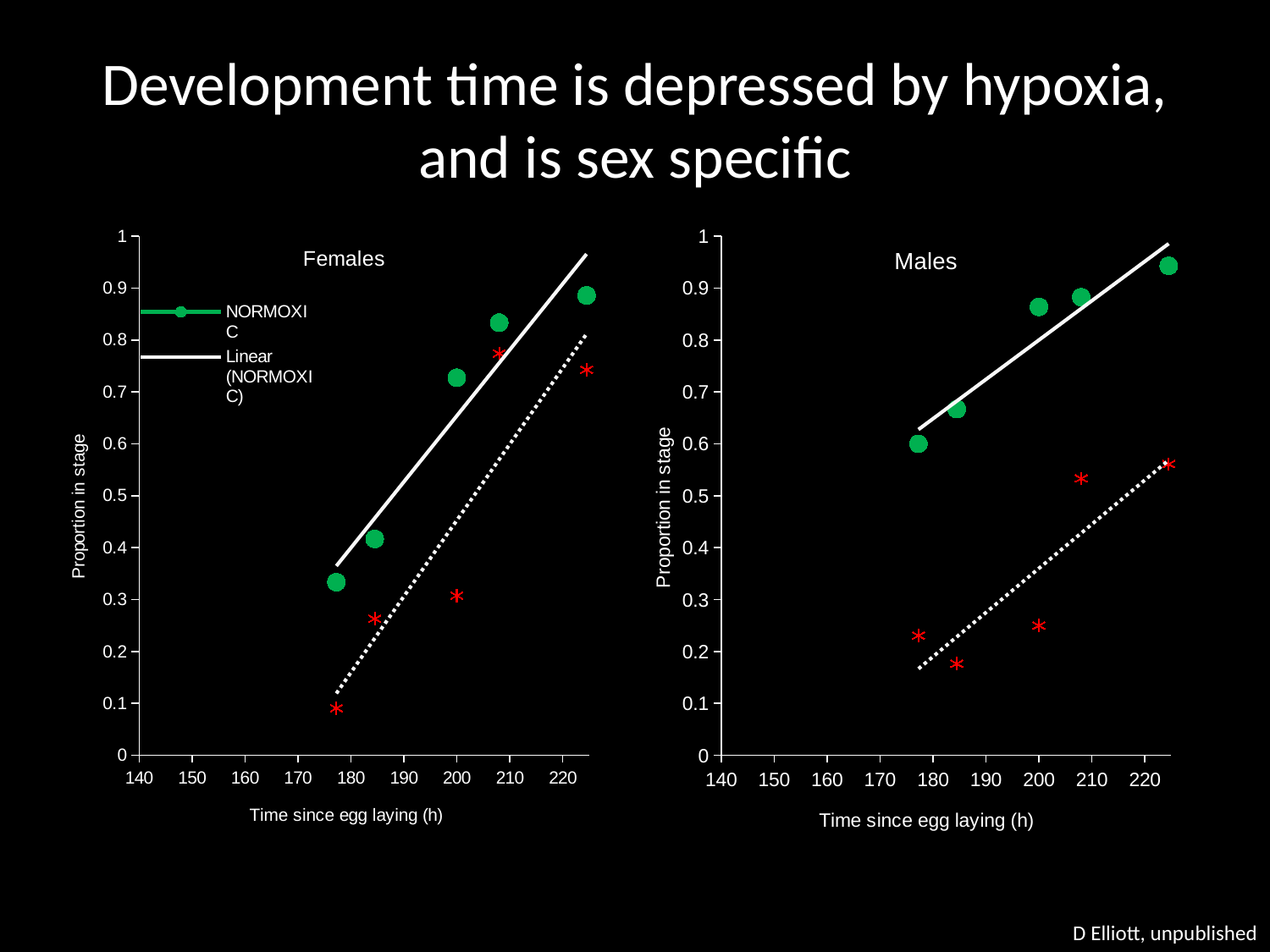
On the Males chart, is the value of the rightmost red asterisk point greater or less than 0.7? less What kind of chart is the Females chart? scatter chart How many red asterisk points are plotted on the Females chart? 5 On the Males chart, do the red asterisk points generally rise or fall as time since egg laying increases? rise How many entries does the legend on the Females chart list? 2 How many green NORMOXIC points are plotted on the Males chart? 5 On the Males chart, at the leftmost time point, which is larger: the green NORMOXIC point or the red asterisk point? the green NORMOXIC point On the Females chart, is the value of the leftmost red asterisk point greater or less than 0.2? less What is the y-axis label on the Males chart? Proportion in stage What are the two legend entries on the Females chart? NORMOXIC and Linear (NORMOXIC) On the Females chart, do the green NORMOXIC points rise or fall as time since egg laying increases? rise On the Males chart, is the value of the rightmost green NORMOXIC point greater or less than 0.9? greater